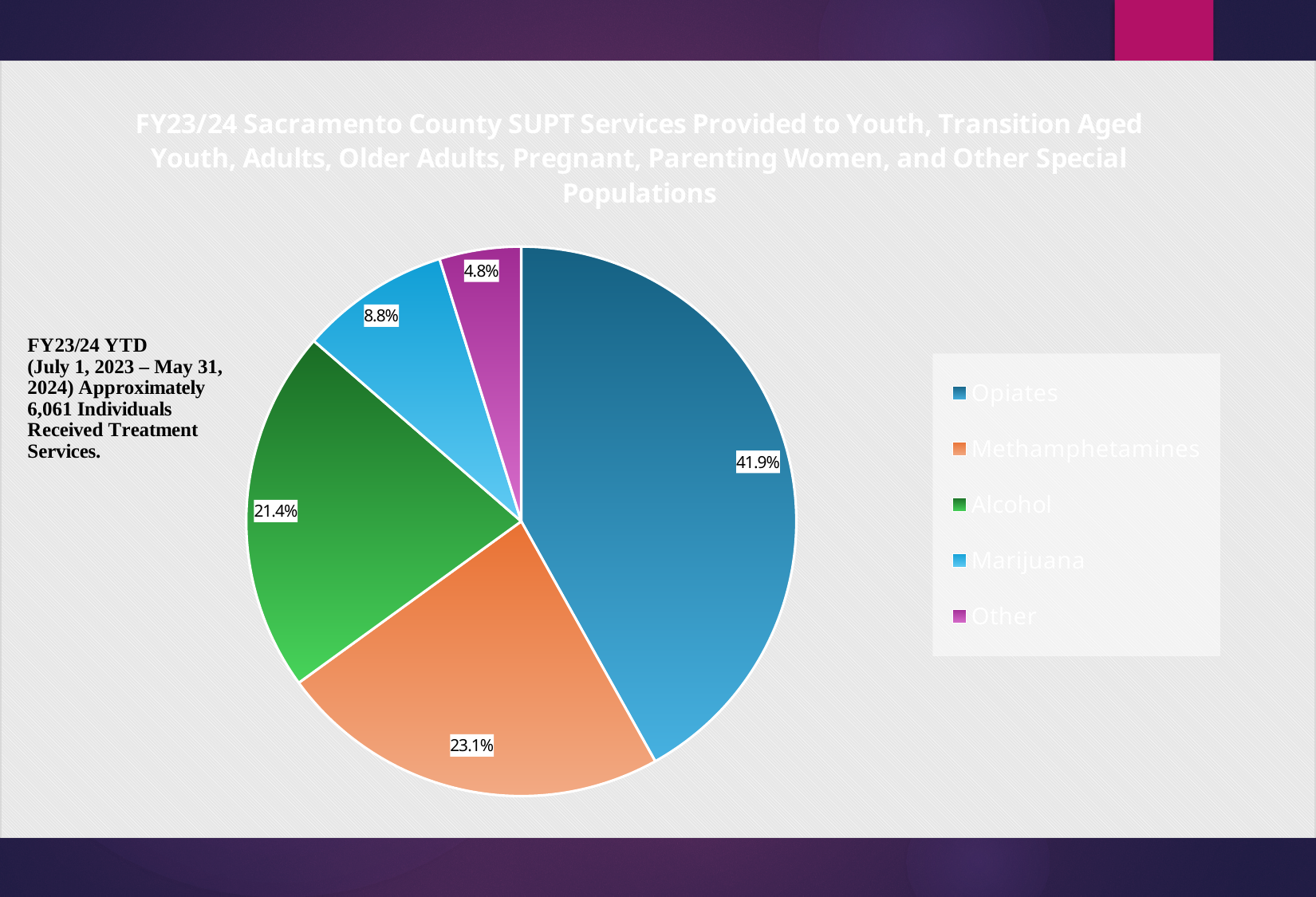
How many categories are shown in the pie chart? 5 What share of the pie does Marijuana account for? 8.8% What is the difference in percentage points between the Opiates slice and the Methamphetamines slice? 18.8 What kind of chart is shown on the slide? Pie chart Which category has the smallest slice of the pie? Other What share of the pie does Opiates account for? 41.9% What share of the pie does Methamphetamines account for? 23.1% Which category has the largest slice of the pie? Opiates Which is larger, the Alcohol slice or the Marijuana slice? Alcohol What colour is the Alcohol slice in the pie chart? Green